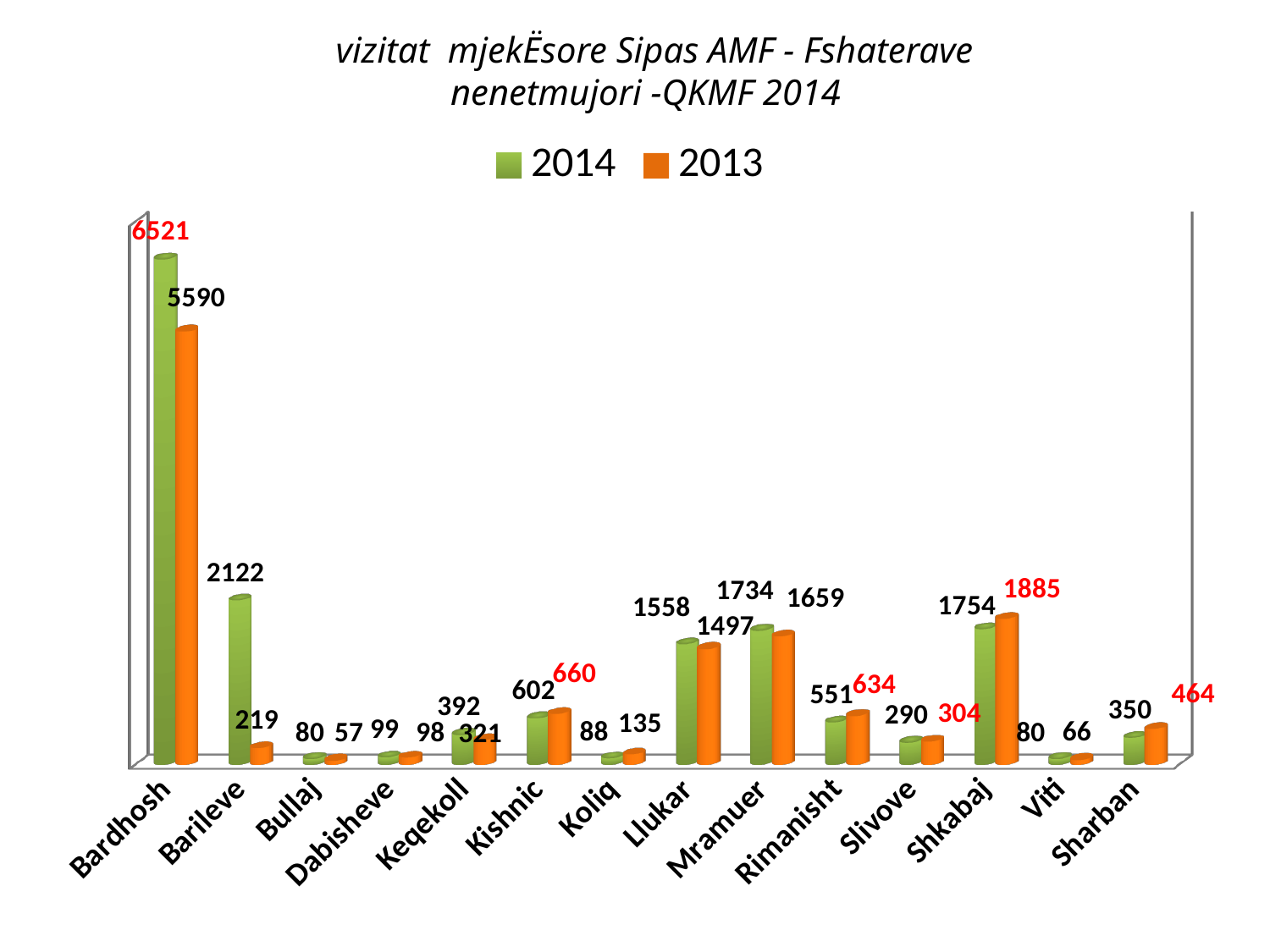
What is the 2013 value for Shkabaj? 1885 Which category has the highest 2014 value? Bardhosh What is the difference between the 2014 and 2013 values for Barileve? 1903 What is the 2014 value for Barileve? 2122 For Kishnic, which is larger: the 2014 value or the 2013 value? 2013 What is the 2014 value for Bardhosh? 6521 What is the 2013 value for Sharban? 464 What is the difference between the 2014 and 2013 values for Bardhosh? 931 How many categories are shown on the x axis? 14 What kind of chart is shown on the slide? Bar chart Which category has the lowest 2013 value? Bullaj How many series does the legend list? 2